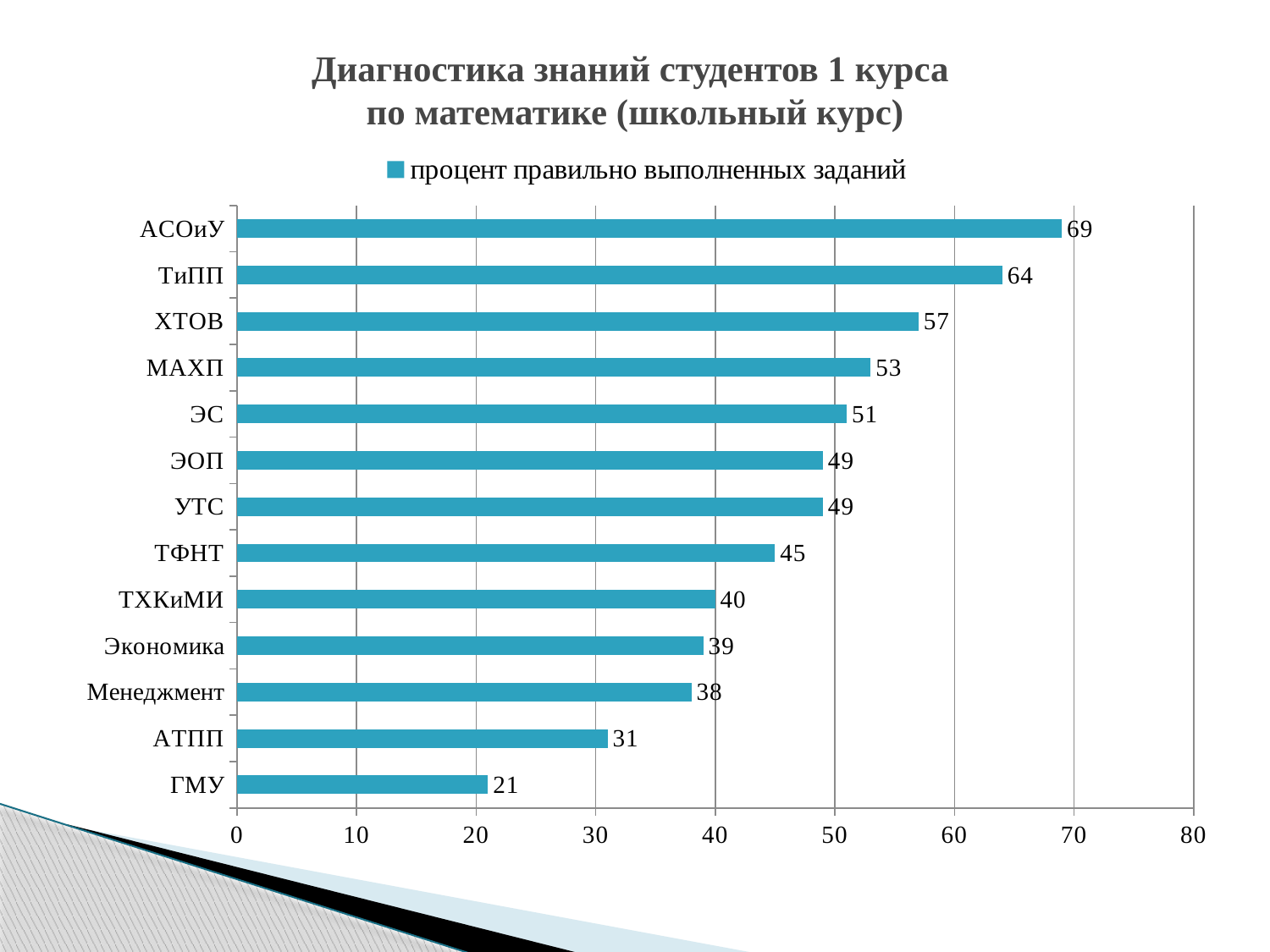
Which category has the lowest value? ГМУ How many categories are shown on the chart? 13 What kind of chart is shown on the slide? bar chart Is the value for АТПП greater or less than 40? less How many series does the legend list? 1 What is the value for Экономика? 39 Which category has the highest value? АСОиУ What is the difference between the values for ТиПП and ХТОВ? 7 Which is larger, the value for МАХП or the value for ТФНТ? МАХП What is the value for АСОиУ? 69 What is the value for ГМУ? 21 What is the legend entry of the chart? процент правильно выполненных заданий